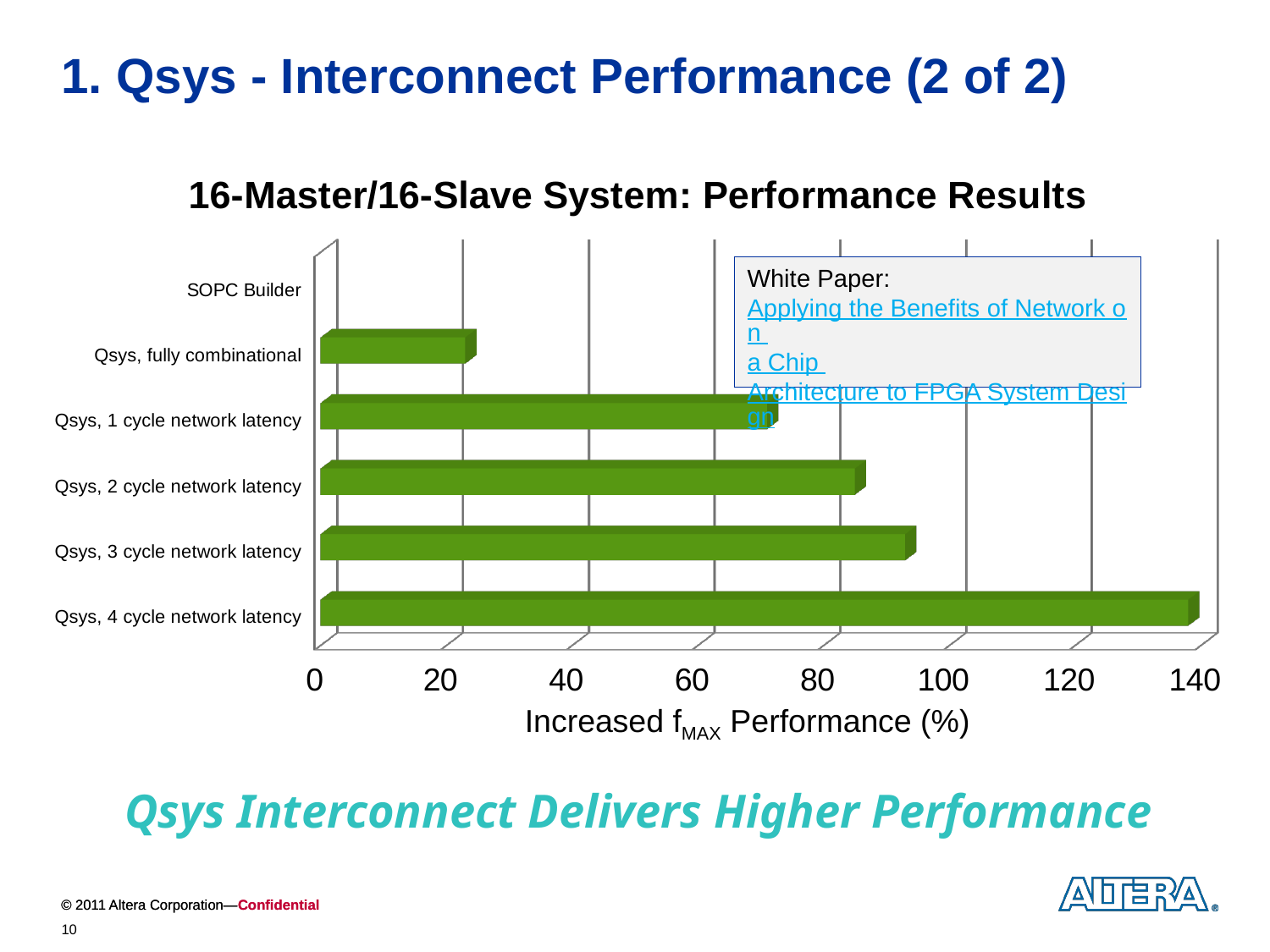
Is the value for Qsys, 1 cycle network latency greater or less than 60? greater How many categories are plotted on the chart? 6 What is the label of the horizontal axis? Increased fMAX Performance (%) Which category has the highest increased fMAX performance? Qsys, 4 cycle network latency Is the value for Qsys, 4 cycle network latency greater or less than 120? greater What is the title of the chart? 16-Master/16-Slave System: Performance Results Is the value for Qsys, 2 cycle network latency greater or less than 80? greater What kind of chart is shown on the slide? bar chart Which category has the lowest increased fMAX performance? SOPC Builder Which is larger, the value for Qsys, 4 cycle network latency or Qsys, 1 cycle network latency? Qsys, 4 cycle network latency